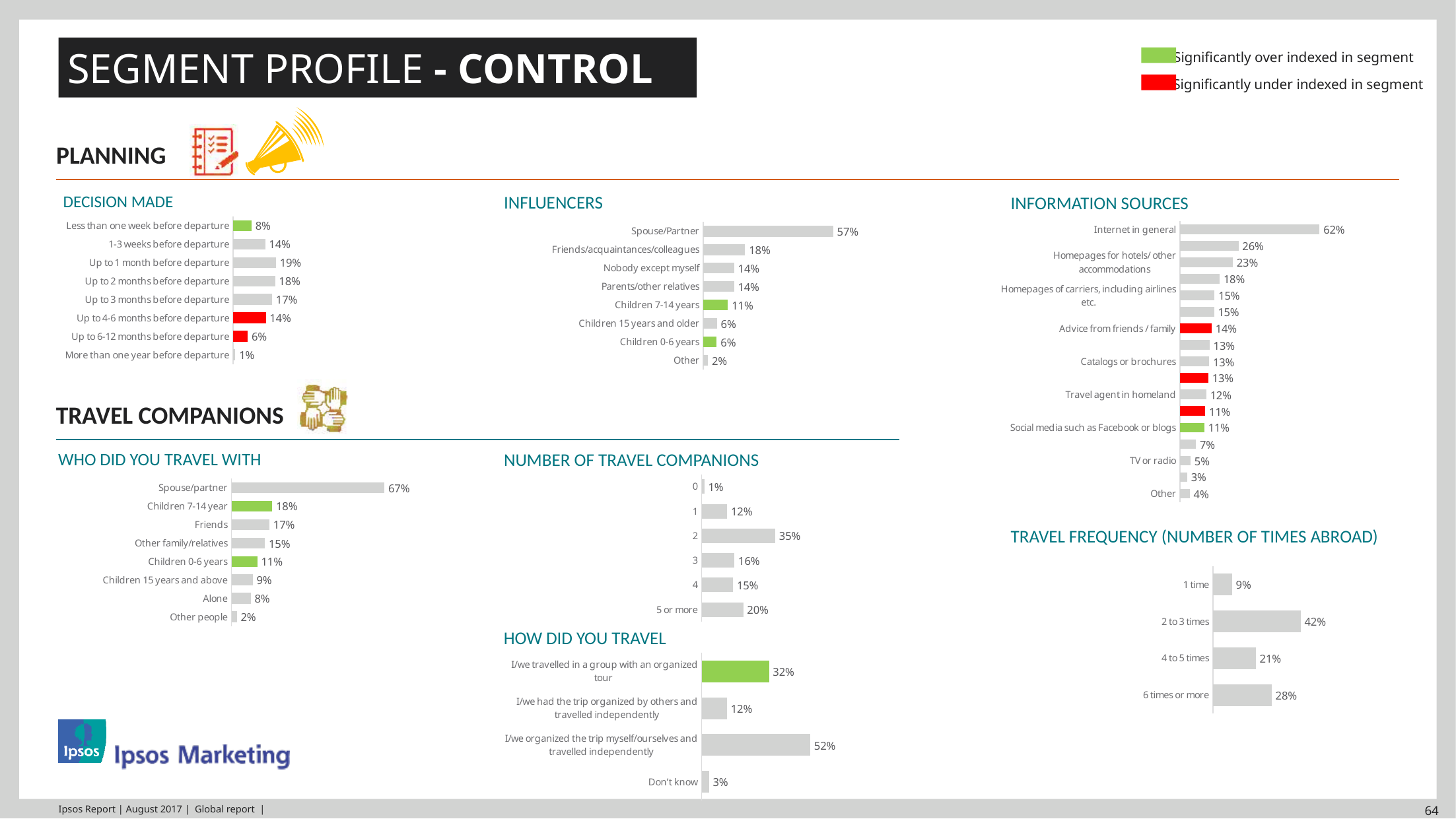
In the "Who did you travel with" chart, how many categories are shown? 8 In the "Who did you travel with" chart, which category has the highest value? Spouse/partner In the "Information sources" chart, what is the value for "Internet in general"? 62% In the "Information sources" chart, what is the value for "TV or radio"? 5% In the "Decision made" chart, what is the value for "Up to 1 month before departure"? 19% In the "Number of travel companions" chart, which is larger: the value for "2" or the value for "5 or more"? 2 What type of chart is the "Travel frequency (number of times abroad)" chart? Bar chart In the "Influencers" chart, what is the difference between "Spouse/Partner" and "Friends/acquaintances/colleagues"? 39 percentage points In the "Influencers" chart, what is the value for "Spouse/Partner"? 57% In the "Travel frequency (number of times abroad)" chart, what is the value for "2 to 3 times"? 42% In the "Decision made" chart, which category has the lowest value? More than one year before departure In the "How did you travel" chart, what is the value for "I/we organized the trip myself/ourselves and travelled independently"? 52%